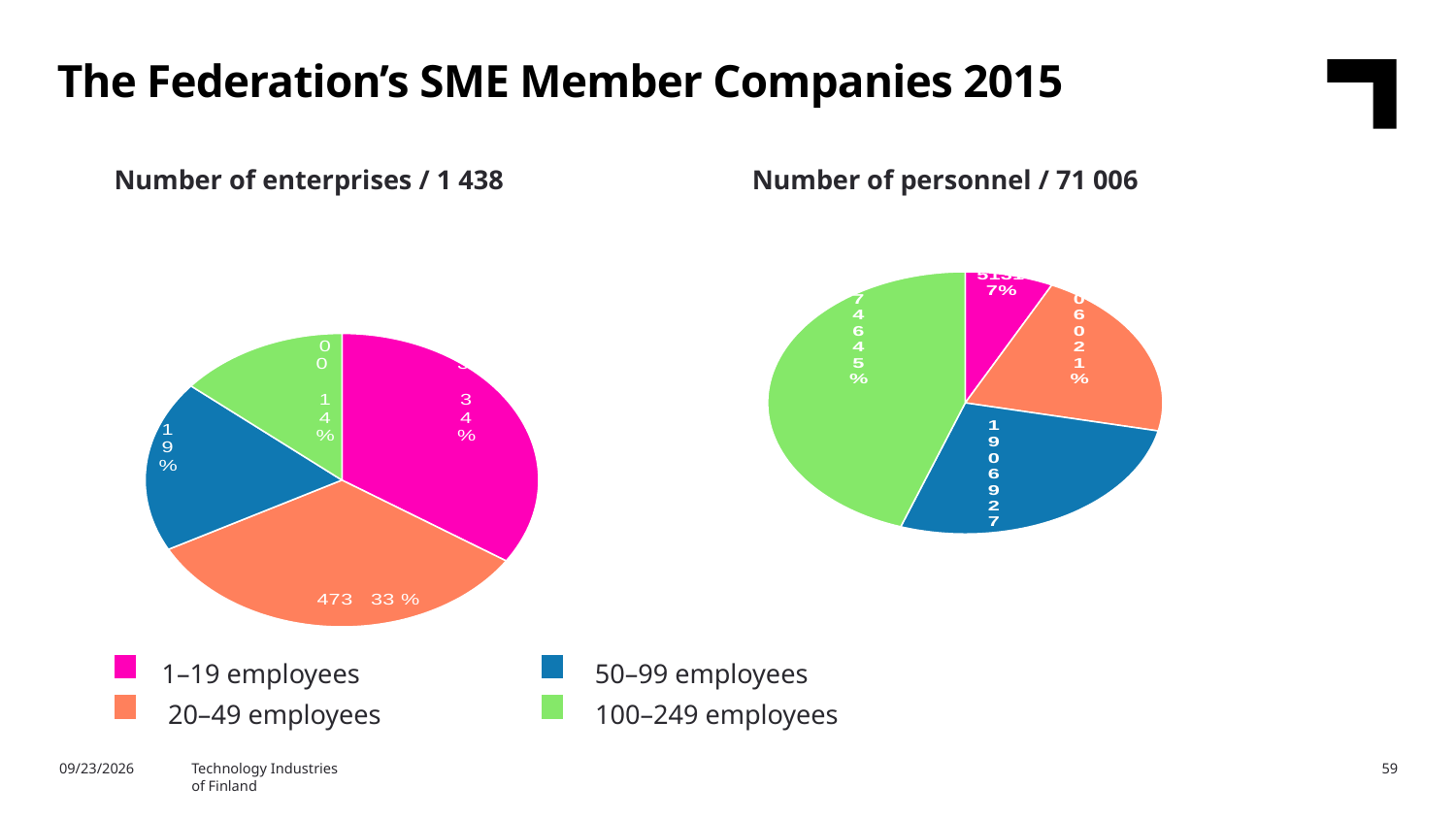
In the 'Number of enterprises' pie chart, what share do companies with 50–99 employees have? 19% How many employee-size categories does the legend list? 4 In the 'Number of personnel' pie chart, which category has the largest slice? 100–249 employees In the 'Number of enterprises' pie chart, what share do companies with 20–49 employees have? 33 % What total number of personnel is given in the title of the right-hand pie chart? 71 006 In the 'Number of enterprises' pie chart, how many enterprises have 20–49 employees? 473 In the 'Number of enterprises' pie chart, which is larger: the slice for 50–99 employees or the slice for 100–249 employees? 50–99 employees In the 'Number of enterprises' pie chart, what share do companies with 100–249 employees have? 14% In the 'Number of enterprises' pie chart, which category has the smallest slice? 100–249 employees What kind of chart is used on this slide for the number of enterprises? Pie chart